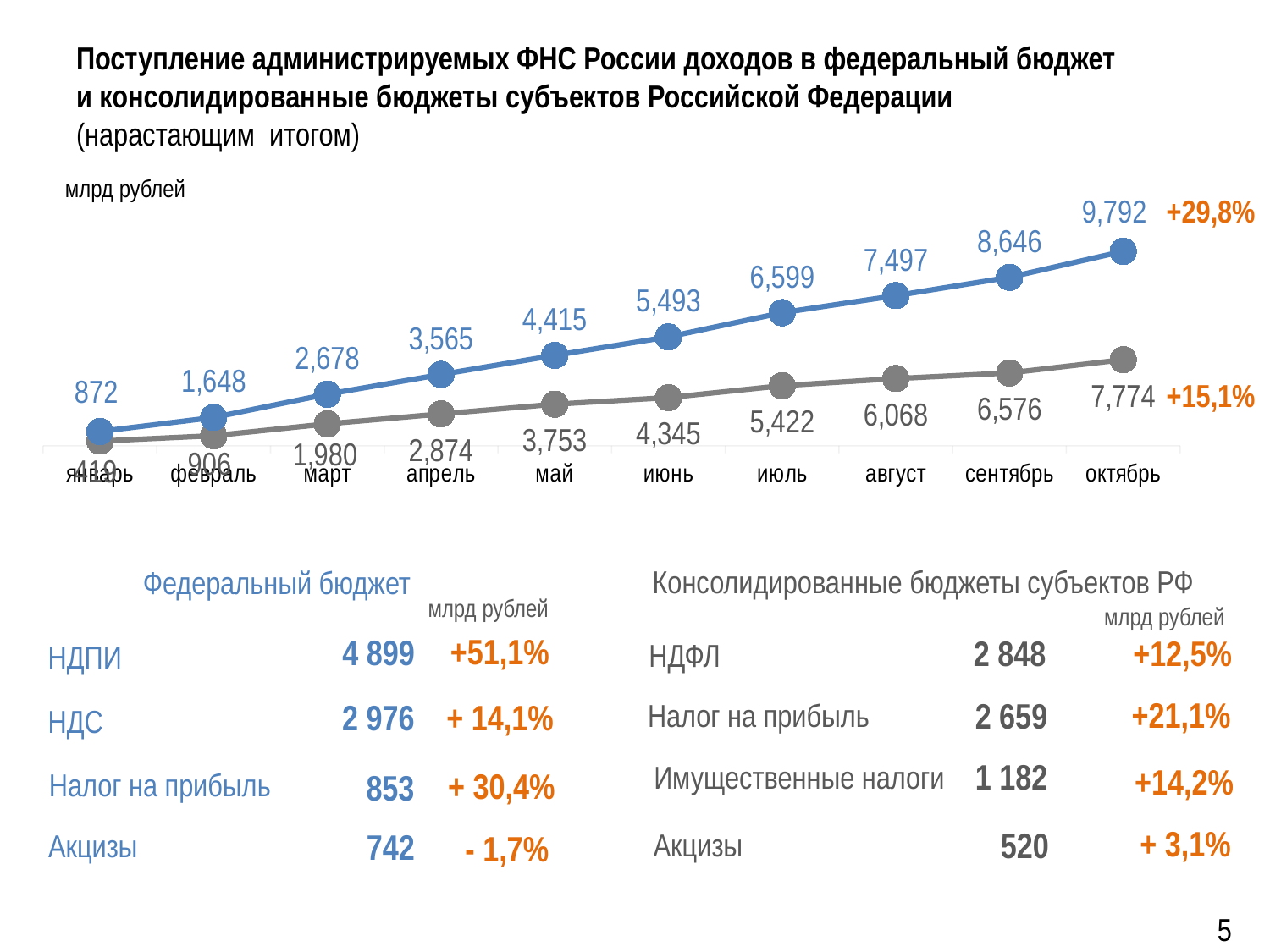
By how much does the blue line increase from сентябрь to октябрь? 1,146 What is the difference between the blue line and the grey line values for октябрь? 2,018 What kind of chart is shown on the slide? line chart For июнь, which line has the larger value, the blue line or the grey line? the blue line Do the values of the blue line rise or fall from январь to октябрь? rise How many months are plotted along the x axis of the chart? 10 In which month does the blue line reach its highest value? октябрь What is the value of the grey (lower) line for июль? 5,422 What percentage change is printed next to the end of the blue line? +29,8% What is the value of the blue (upper) line for октябрь? 9,792 What is the value of the blue (upper) line for май? 4,415 What is the value of the grey (lower) line for октябрь? 7,774